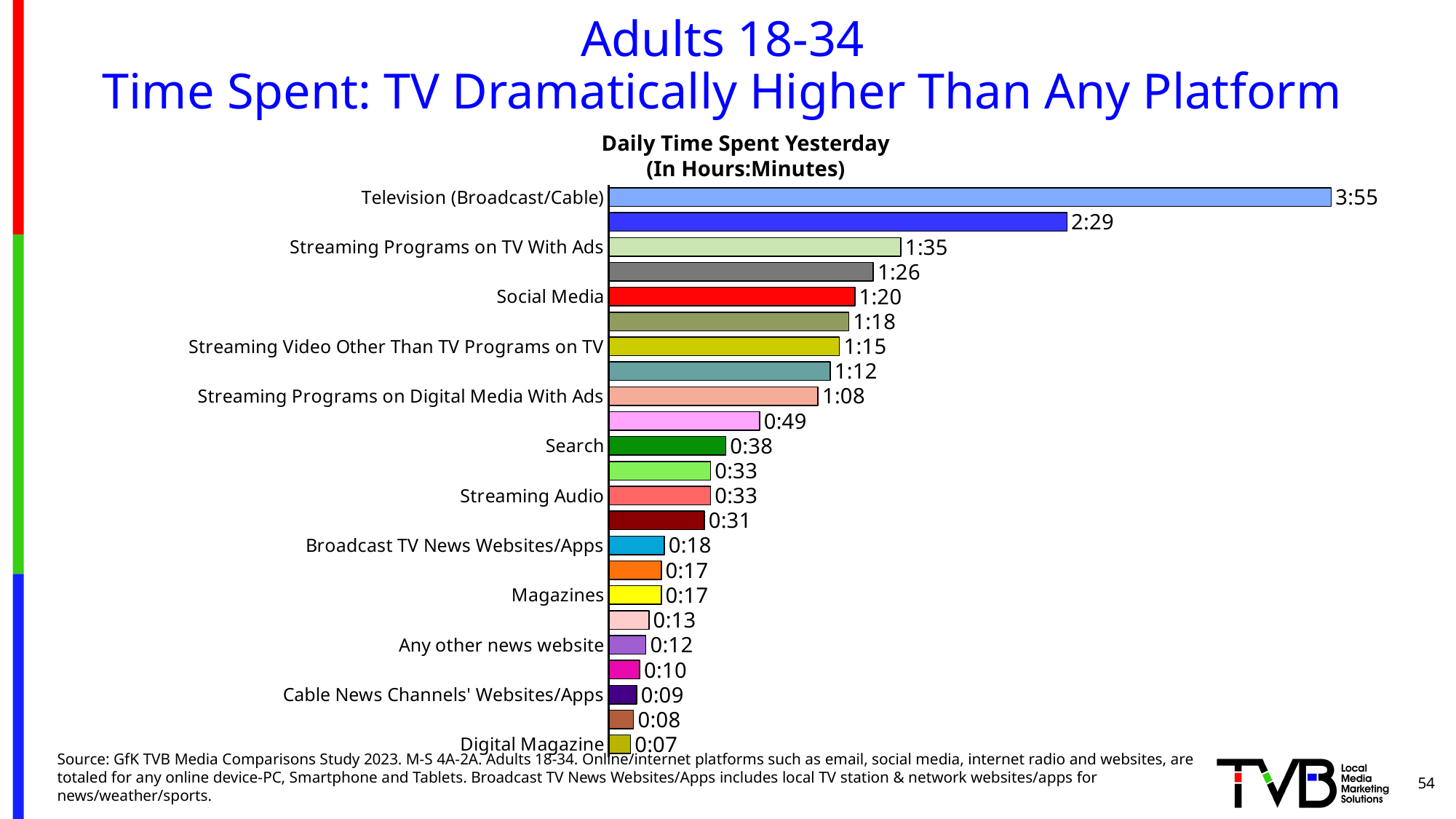
What is the daily time spent for Social Media? 1:20 Which has a higher daily time spent: Streaming Audio or Magazines? Streaming Audio What is the daily time spent for Streaming Programs on Digital Media With Ads? 1:08 Which labeled category has the lowest daily time spent? Digital Magazine How much more daily time is spent on Television (Broadcast/Cable) than on Streaming Programs on TV With Ads? 2:20 What is the daily time spent for Cable News Channels' Websites/Apps? 0:09 How many bars are plotted in the chart? 23 What type of chart is shown on the slide? Bar chart How much more daily time is spent on Social Media than on Search? 0:42 What is the daily time spent for Search? 0:38 Which labeled category has the highest daily time spent? Television (Broadcast/Cable) What is the daily time spent for Television (Broadcast/Cable)? 3:55